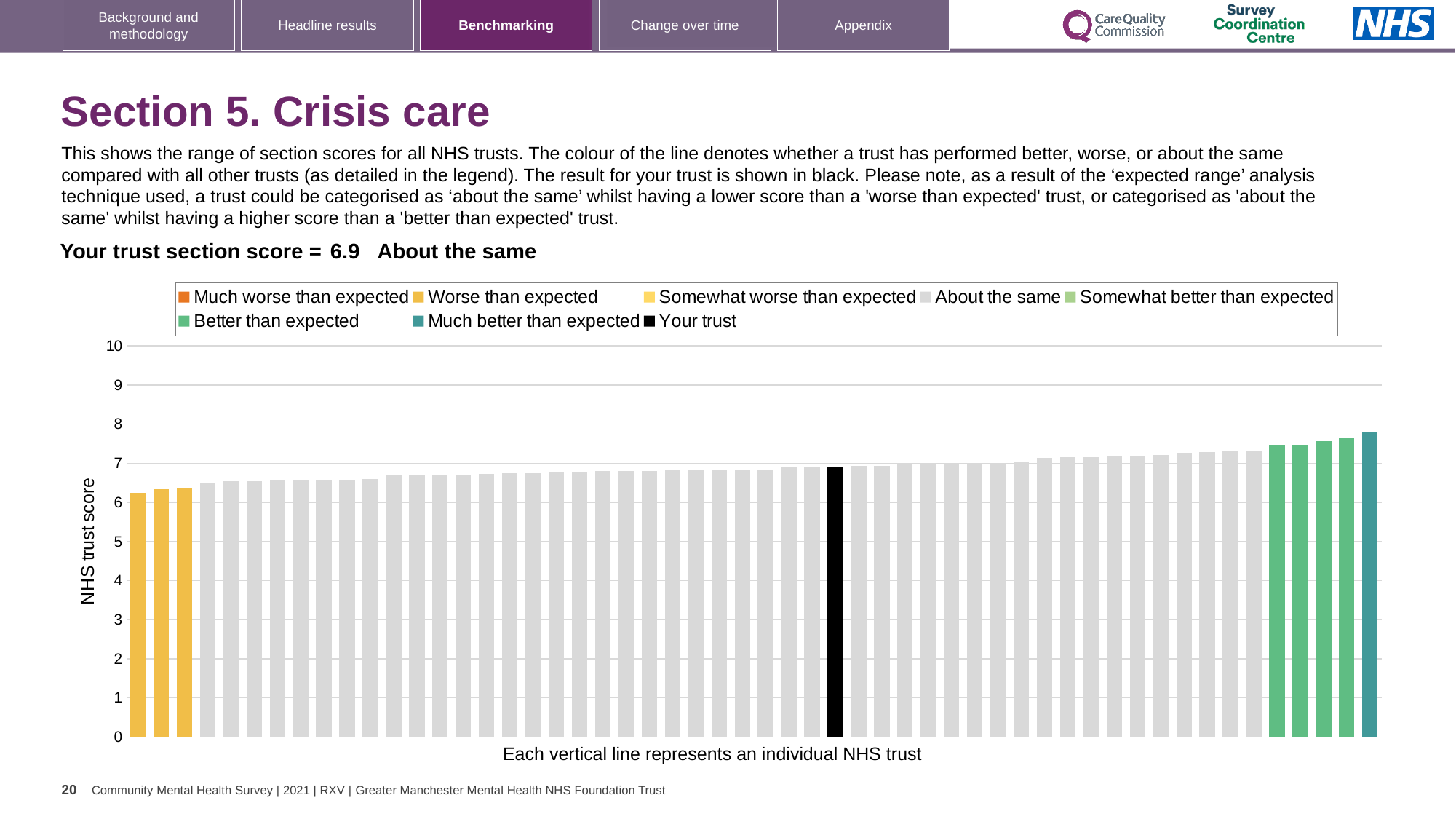
How many bars are coloured as 'Better than expected' (green)? 4 What is the section score for your trust shown on the slide? 6.9 How many bars are coloured as 'Worse than expected' (yellow)? 3 Is the value of the highest bar in the chart greater or less than 8? less How many entries does the chart legend list? 8 Which legend category does the highest bar in the chart belong to? Much better than expected What is the label on the y axis of the chart? NHS trust score Is the value of the lowest bar in the chart greater or less than 7? less Which legend category does the lowest bar in the chart belong to? Worse than expected Do the bar values rise or fall from left to right along the x axis? rise What kind of chart is shown on the slide? bar chart Is the value for your trust (the black bar) greater or less than 5? greater